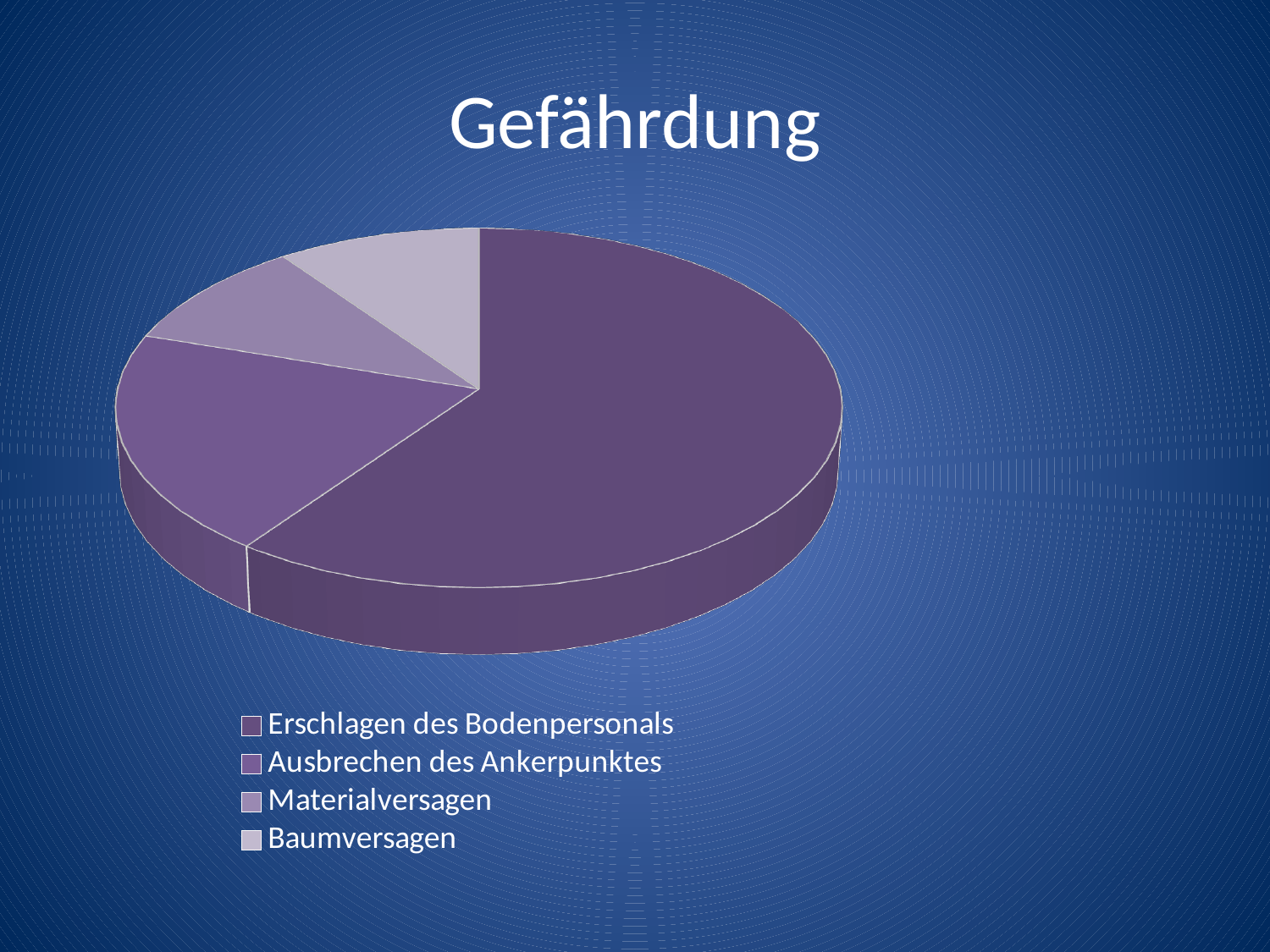
Which category is listed last in the legend? Baumversagen Which slice is larger: Ausbrechen des Ankerpunktes or Baumversagen? Ausbrechen des Ankerpunktes Which slice is larger: Ausbrechen des Ankerpunktes or Materialversagen? Ausbrechen des Ankerpunktes Which category has the largest slice of the pie? Erschlagen des Bodenpersonals What kind of chart is shown on the slide? Pie chart What is the title of the chart? Gefährdung Which slice is larger: Erschlagen des Bodenpersonals or Ausbrechen des Ankerpunktes? Erschlagen des Bodenpersonals How many categories (slices) does the pie chart have? 4